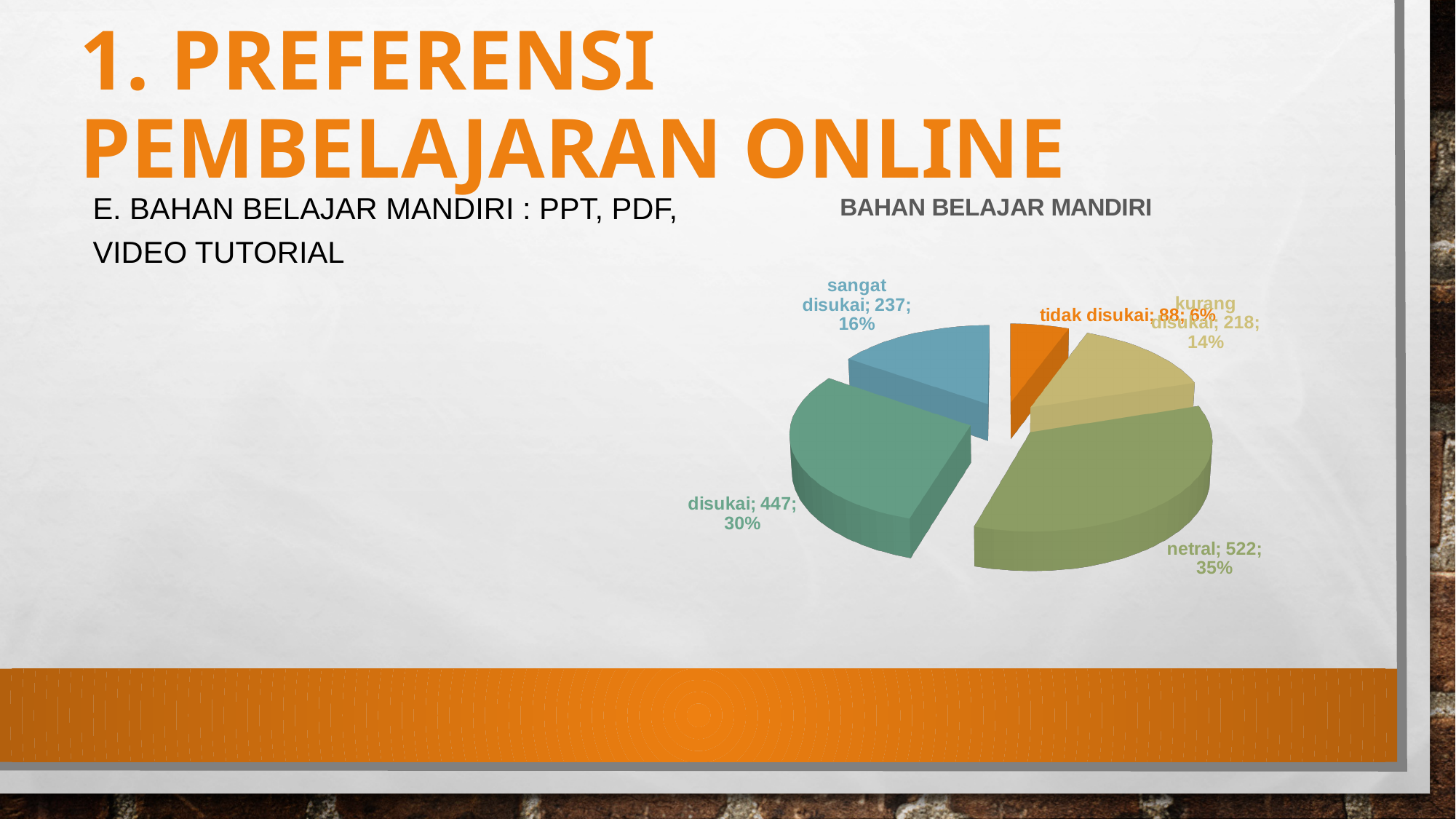
Which category has the largest slice? netral What is the difference between the values for netral and disukai? 75 How many slices does the pie chart have? 5 What share of the pie does disukai represent? 30% What kind of chart is shown on the slide? pie chart What is the title of the chart? BAHAN BELAJAR MANDIRI What is the value for disukai? 447 Which is larger, the value for sangat disukai or the value for kurang disukai? sangat disukai What is the value for tidak disukai? 88 What is the value for sangat disukai? 237 What is the value for netral? 522 Which category has the smallest slice? tidak disukai